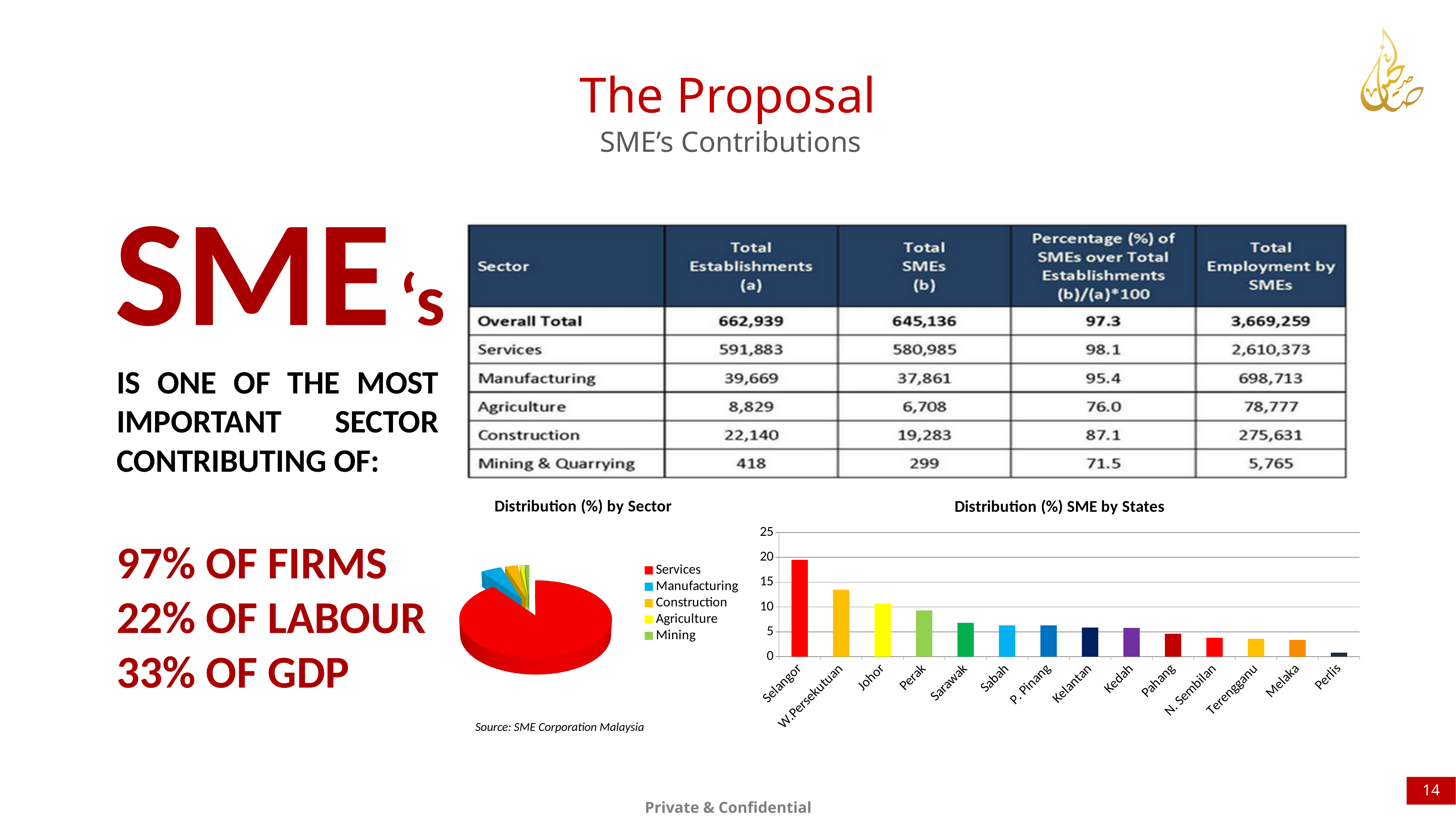
How many states are shown in the 'Distribution (%) SME by States' chart? 14 What kind of chart is the 'Distribution (%) SME by States' chart? bar chart In the 'Distribution (%) SME by States' chart, is the value for Pahang greater or less than 5? less What kind of chart is the 'Distribution (%) by Sector' chart? pie chart In the 'Distribution (%) SME by States' chart, which is larger, the value for Selangor or the value for W.Persekutuan? Selangor In the 'Distribution (%) SME by States' chart, is the value for Perak greater or less than 10? less How many sectors does the legend of the 'Distribution (%) by Sector' pie chart list? 5 In the 'Distribution (%) SME by States' chart, is the value for Selangor greater or less than 15? greater In the 'Distribution (%) SME by States' chart, which state has the lowest value? Perlis In the 'Distribution (%) SME by States' chart, do the values rise or fall from left to right along the x axis? fall In the 'Distribution (%) SME by States' chart, which state has the highest value? Selangor In the 'Distribution (%) by Sector' pie chart, which sector has the largest slice? Services